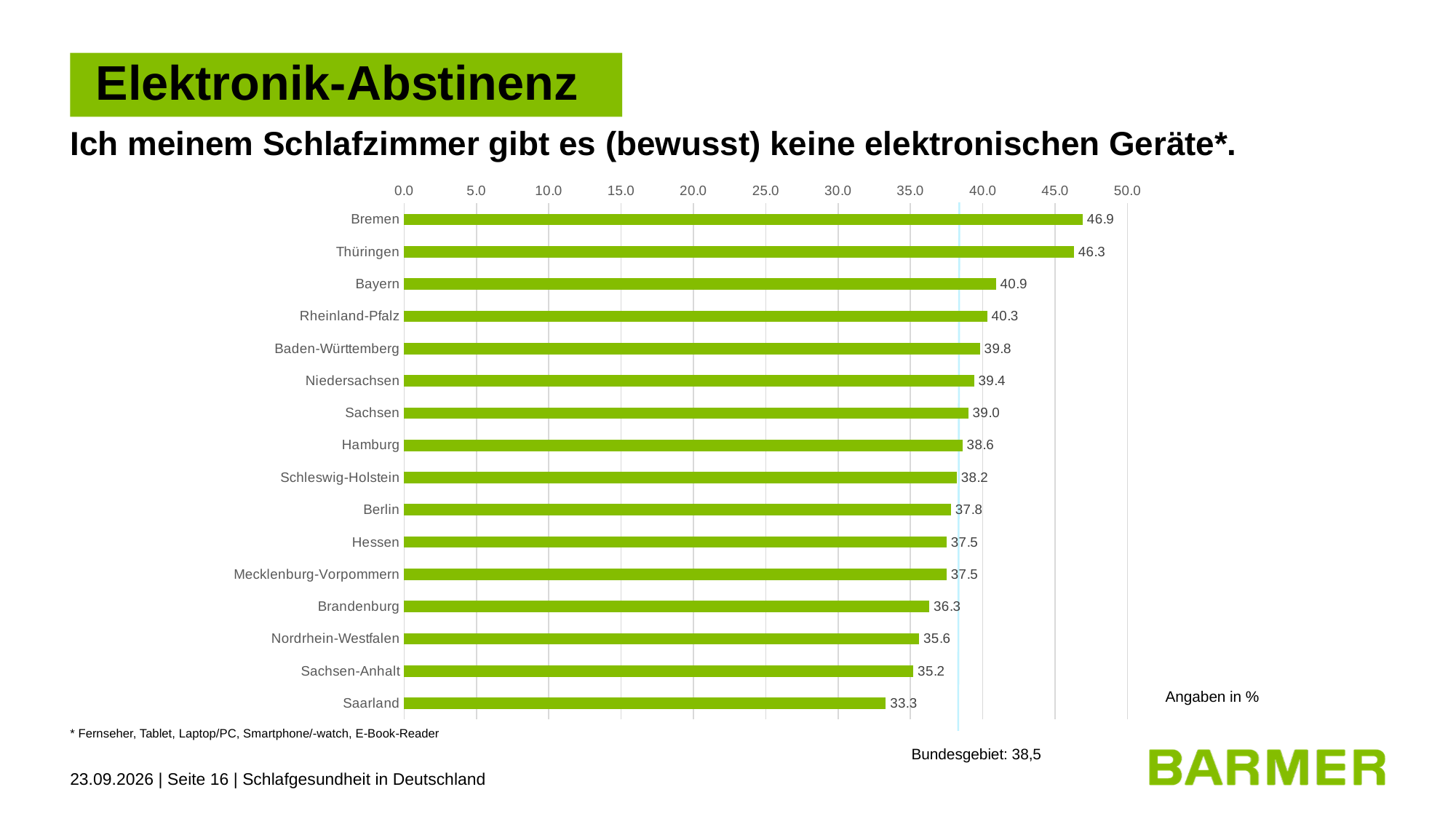
Which has a larger value, Thüringen or Hamburg? Thüringen What is the value for Niedersachsen? 39.4 What kind of chart is shown on the slide? bar chart What is the difference between the values for Bremen and Saarland? 13.6 Which federal state has the highest value? Bremen What is the difference between the values for Bayern and Rheinland-Pfalz? 0.6 How many federal states are shown in the chart? 16 Is the value for Brandenburg greater or less than 40.0? less What is the value for Bremen? 46.9 Which federal state has the lowest value? Saarland What value is given for Bundesgebiet on the slide? 38,5 What is the value for Sachsen-Anhalt? 35.2